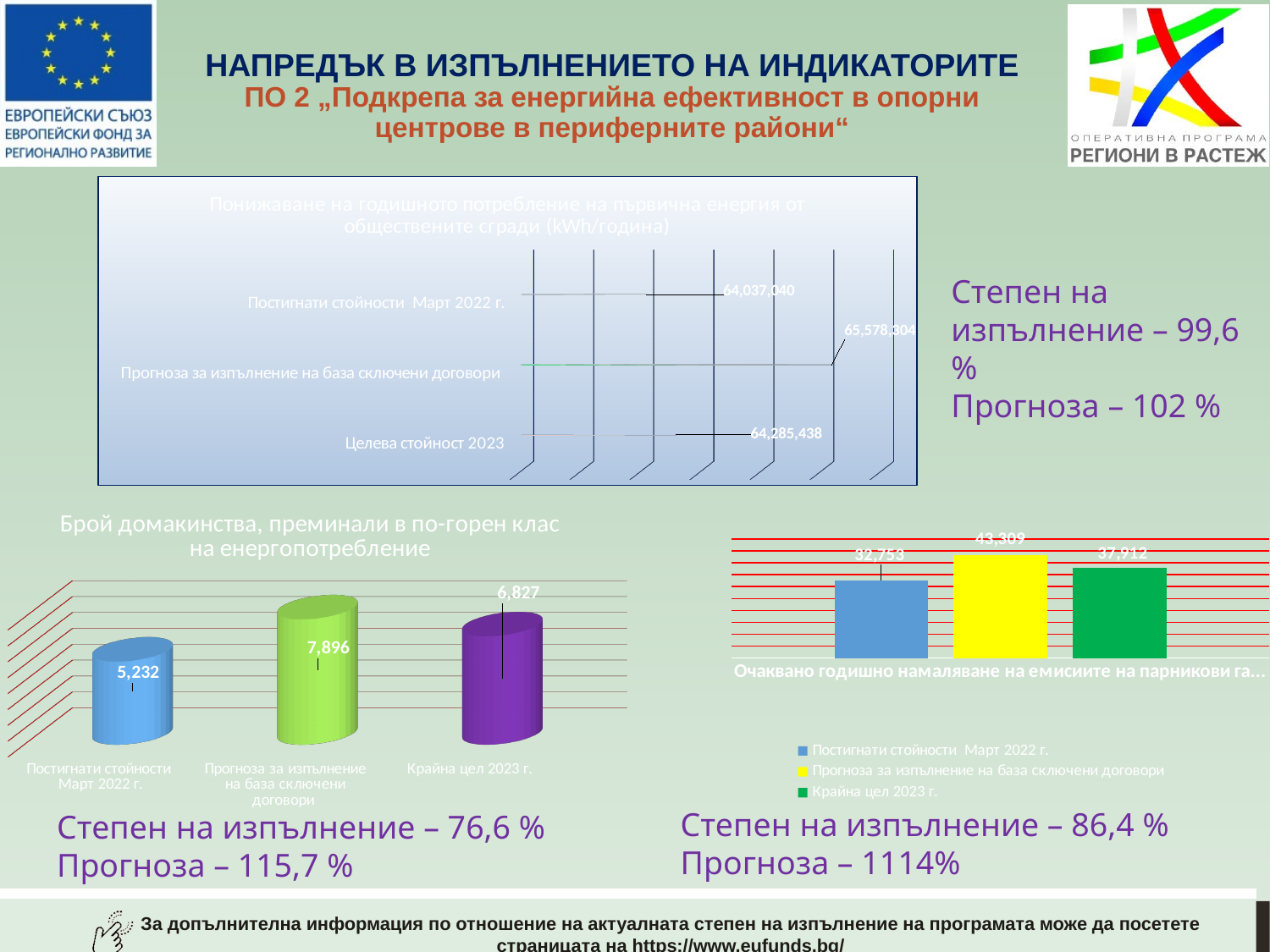
In the top chart on reducing annual primary energy consumption of public buildings, what is the value for Постигнати стойности Март 2022 г.? 64,037,040 How many series does the legend of the bottom-right chart on expected annual reduction of greenhouse gas emissions list? 3 In the bottom-right chart on expected annual reduction of greenhouse gas emissions, which is larger: Постигнати стойности Март 2022 г. or Крайна цел 2023 г.? Крайна цел 2023 г. In the bottom-left chart 'Брой домакинства, преминали в по-горен клас на енергопотребление', which category has the highest value? Прогноза за изпълнение на база сключени договори In the bottom-left chart 'Брой домакинства, преминали в по-горен клас на енергопотребление', what is the difference between Прогноза за изпълнение на база сключени договори and Постигнати стойности Март 2022 г.? 2,664 In the bottom-right chart on expected annual reduction of greenhouse gas emissions, what is the value for Прогноза за изпълнение на база сключени договори? 43,309 In the bottom-left chart 'Брой домакинства, преминали в по-горен клас на енергопотребление', what is the value for Постигнати стойности Март 2022 г.? 5,232 In the top chart on reducing annual primary energy consumption of public buildings, what is the value for Целева стойност 2023? 64,285,438 In the bottom-left chart 'Брой домакинства, преминали в по-горен клас на енергопотребление', what is the value for Крайна цел 2023 г.? 6,827 What kind of chart is the bottom-left chart 'Брой домакинства, преминали в по-горен клас на енергопотребление'? Bar chart In the top chart on reducing annual primary energy consumption of public buildings, which category has the highest value? Прогноза за изпълнение на база сключени договори In the top chart on reducing annual primary energy consumption of public buildings, how many categories are plotted? 3